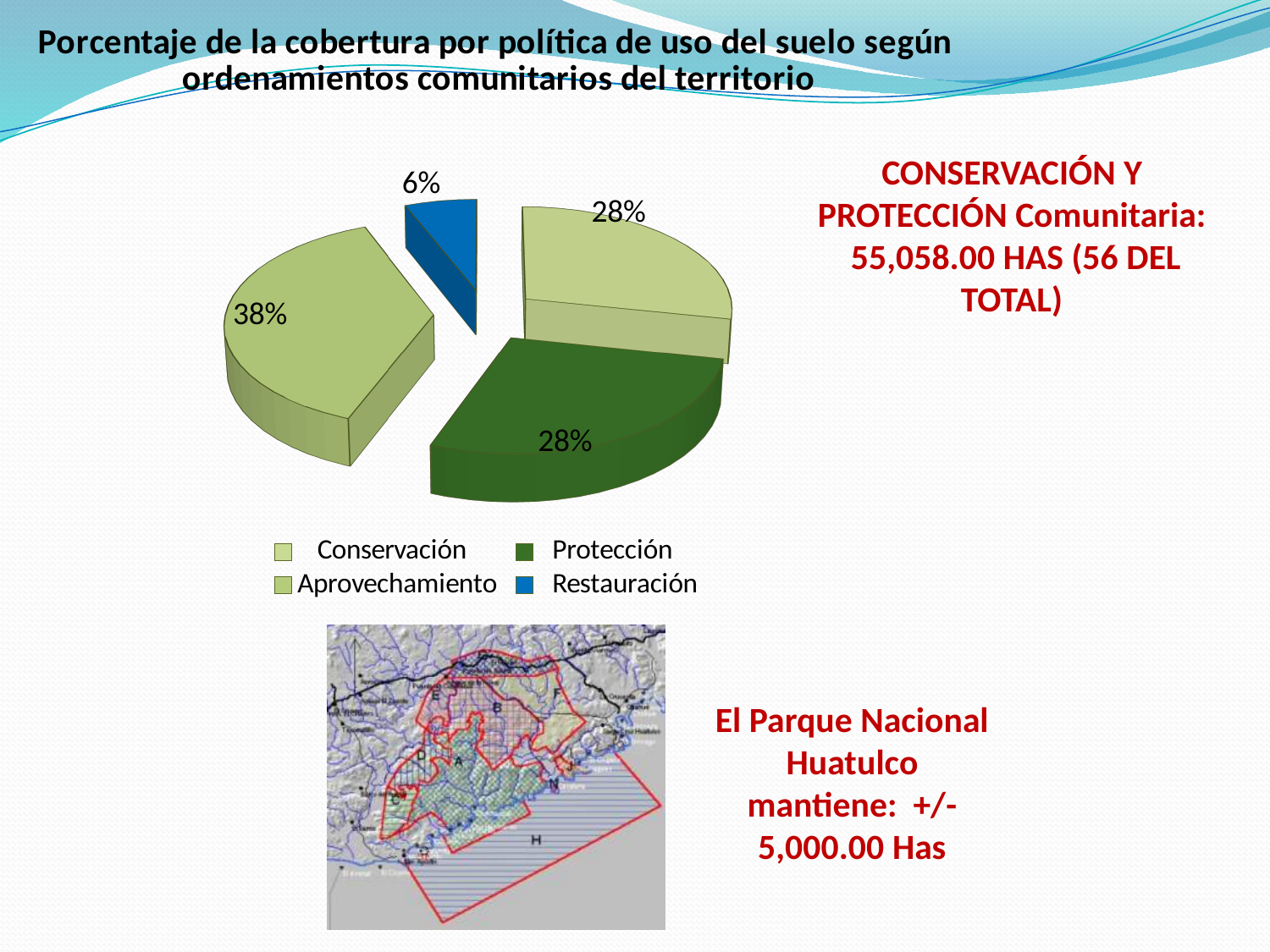
Which is larger in the pie chart, Aprovechamiento or Restauración? Aprovechamiento What is the difference in percentage points between Aprovechamiento and Restauración? 32 Which category has the largest slice of the pie chart? Aprovechamiento What kind of chart is shown on the slide? pie chart How many slices does the pie chart have? 4 What percentage of the pie does Aprovechamiento represent? 38% What is the value shown for Conservación in the pie chart? 28% Which colour represents Restauración in the pie chart? blue Which category has the smallest slice of the pie chart? Restauración What percentage of the pie does Restauración represent? 6% How many entries does the legend of the pie chart list? 4 What is the value shown for Protección in the pie chart? 28%